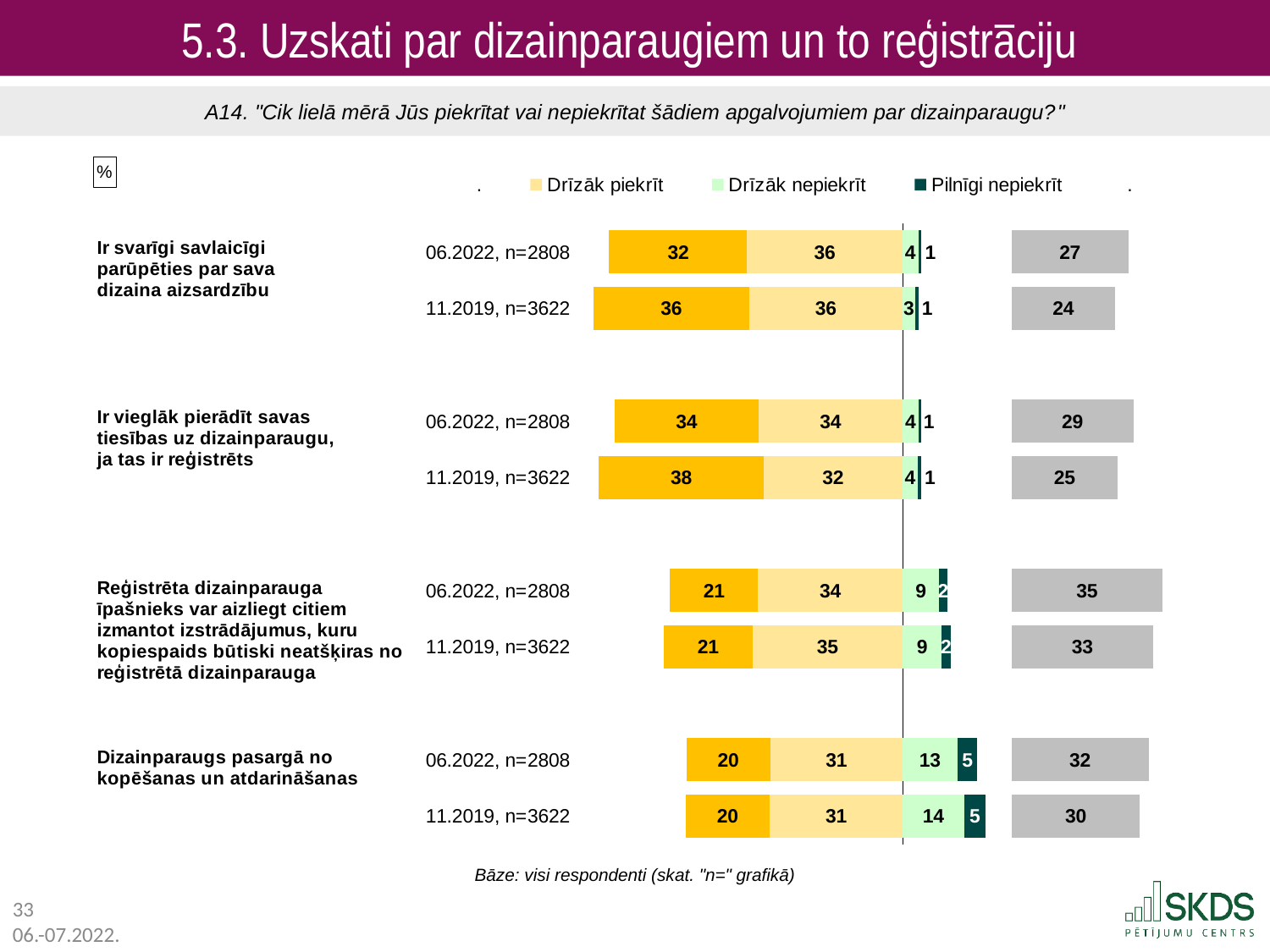
What is the "Drīzāk piekrīt" value for "Dizainparaugs pasargā no kopēšanas un atdarināšanas" in 06.2022, n=2808? 31 What is the survey question quoted above the chart? A14. "Cik lielā mērā Jūs piekrītat vai nepiekrītat šādiem apgalvojumiem par dizainparaugu?" What is the difference between the "Drīzāk nepiekrīt" values for "Dizainparaugs pasargā no kopēšanas un atdarināšanas" in 11.2019 and 06.2022? 1 What is the "Pilnīgi nepiekrīt" value for "Reģistrēta dizainparauga īpašnieks var aizliegt citiem izmantot izstrādājumus..." in 06.2022, n=2808? 2 Which statement has the highest "Drīzāk nepiekrīt" value in 06.2022, n=2808? Dizainparaugs pasargā no kopēšanas un atdarināšanas What is the "Drīzāk nepiekrīt" value for "Dizainparaugs pasargā no kopēšanas un atdarināšanas" in 11.2019, n=3622? 14 Which statement has the highest grey-bar value in 06.2022, n=2808? Reģistrēta dizainparauga īpašnieks var aizliegt citiem izmantot izstrādājumus, kuru kopiespaids būtiski neatšķiras no reģistrētā dizainparauga What value is shown in the grey bar for "Ir vieglāk pierādīt savas tiesības uz dizainparaugu, ja tas ir reģistrēts" in 11.2019, n=3622? 25 What kind of chart is shown on the slide? bar chart Which is larger in 06.2022, n=2808: the "Drīzāk piekrīt" value for "Ir svarīgi savlaicīgi parūpēties par sava dizaina aizsardzību" or for "Ir vieglāk pierādīt savas tiesības uz dizainparaugu, ja tas ir reģistrēts"? Ir svarīgi savlaicīgi parūpēties par sava dizaina aizsardzību How many statements (categories) are shown in the chart? 4 What is the total of the four coloured (non-grey) segments for "Dizainparaugs pasargā no kopēšanas un atdarināšanas" in 06.2022, n=2808? 69